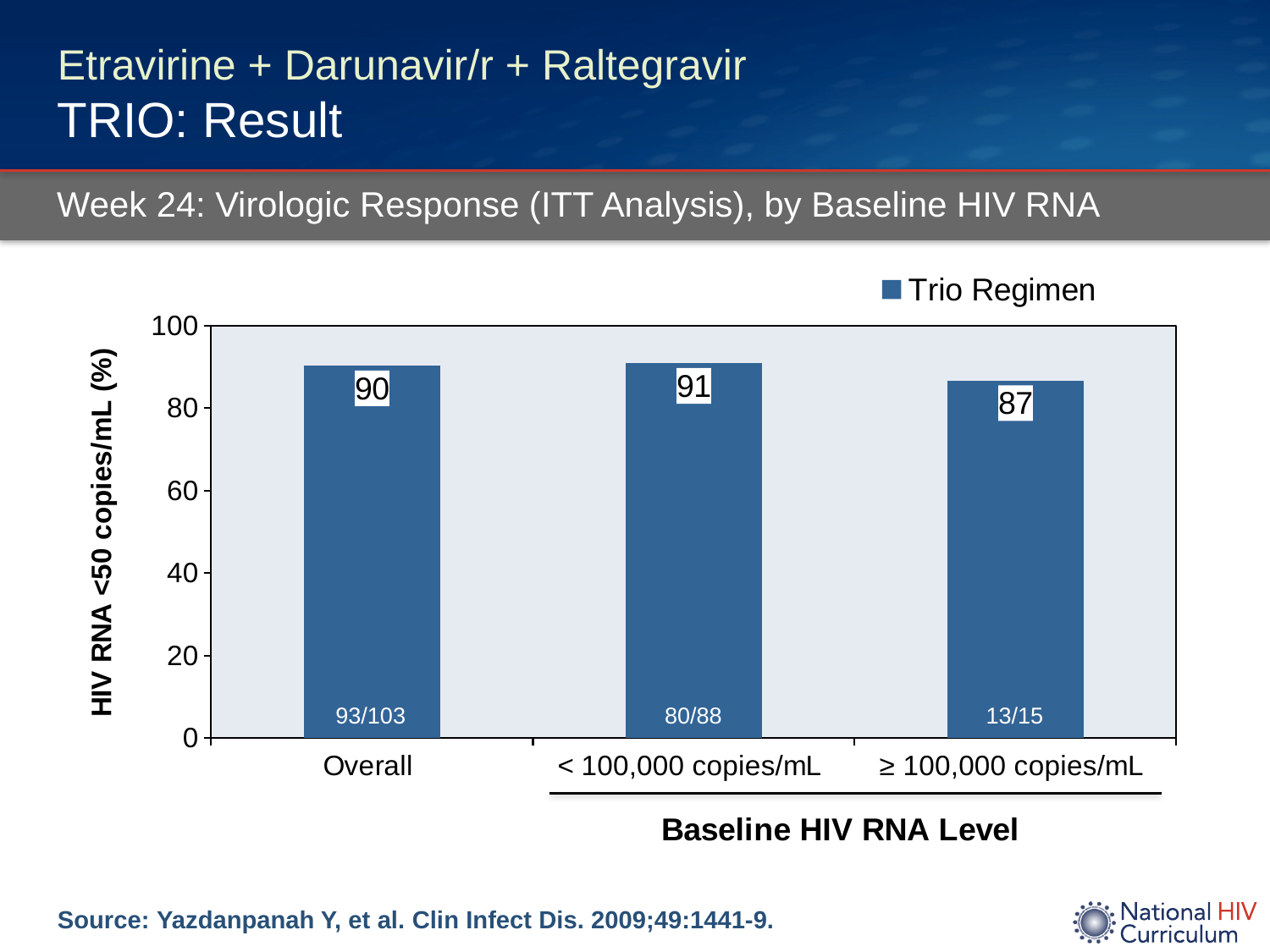
What is the value for Overall? 90 Which category has the lowest value? ≥ 100,000 copies/mL How many series does the legend list? 1 Which category has the highest value? < 100,000 copies/mL What is the value for < 100,000 copies/mL? 91 How many categories are shown on the x axis? 3 What is the fraction printed at the bottom of the Overall bar? 93/103 What is the difference between the values for < 100,000 copies/mL and ≥ 100,000 copies/mL? 4 What is the value for ≥ 100,000 copies/mL? 87 What kind of chart is shown? bar chart Is the value for ≥ 100,000 copies/mL greater or less than 80? greater Which is larger, the value for Overall or the value for ≥ 100,000 copies/mL? Overall